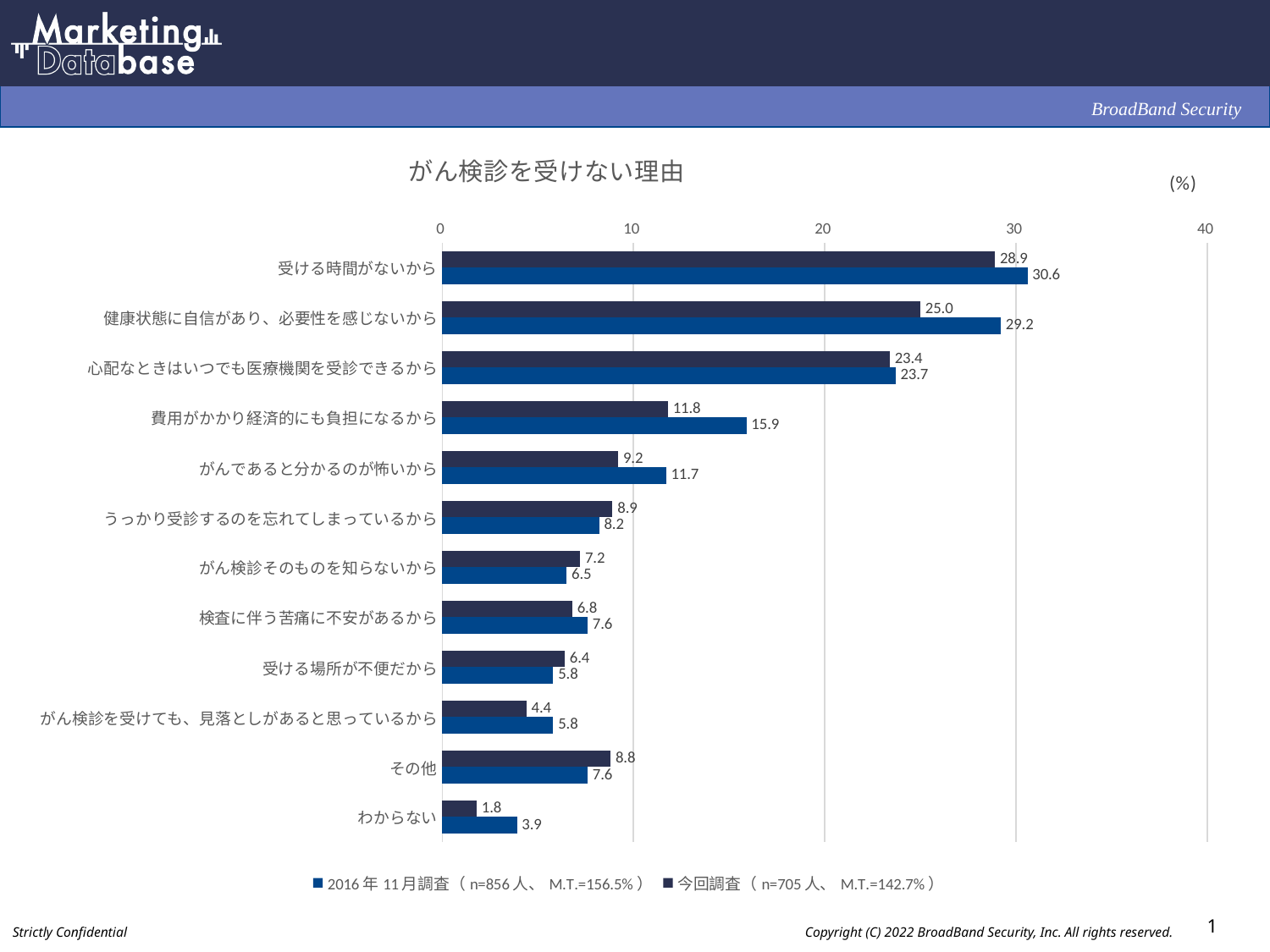
Which category has the lowest value in the 2016年11月調査 series? わからない How many categories (reasons) are shown on the chart? 12 What is the title of the chart? がん検診を受けない理由 What is the value for 受ける時間がないから in the 今回調査 series? 28.9 What is the value for わからない in the 今回調査 series? 1.8 How many series does the legend list? 2 For がんであると分かるのが怖いから, which series has the larger value, 2016年11月調査 or 今回調査? 2016年11月調査 What is the difference between the 今回調査 and 2016年11月調査 values for 健康状態に自信があり、必要性を感じないから? 4.2 What is the value for 費用がかかり経済的にも負担になるから in the 2016年11月調査 series? 15.9 What type of chart is shown on the slide? Bar chart Is the 今回調査 value for 心配なときはいつでも医療機関を受診できるから greater or less than 20? greater Which category has the highest value in the 今回調査 series? 受ける時間がないから